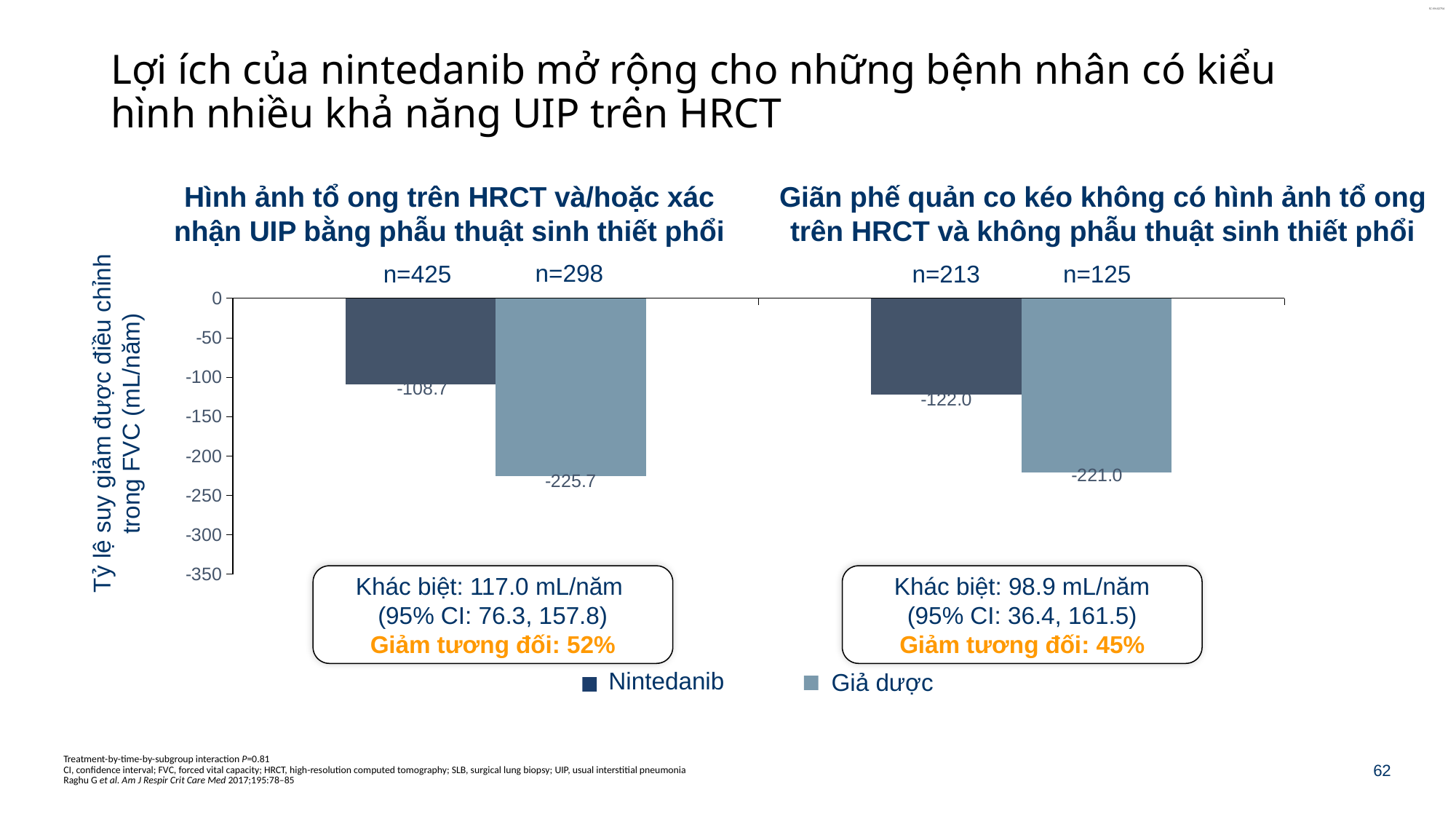
What is the adjusted annual rate of FVC decline for Nintedanib in the group 'Hình ảnh tổ ong trên HRCT và/hoặc xác nhận UIP bằng phẫu thuật sinh thiết phổi'? -108.7 What is the adjusted annual rate of FVC decline for Giả dược in the group 'Giãn phế quản co kéo không có hình ảnh tổ ong trên HRCT và không phẫu thuật sinh thiết phổi'? -221.0 Which bar shows the largest decline in FVC (the most negative value) on the chart? Giả dược in the 'Hình ảnh tổ ong trên HRCT và/hoặc xác nhận UIP bằng phẫu thuật sinh thiết phổi' group (-225.7) What is the adjusted annual rate of FVC decline for Giả dược in the group 'Hình ảnh tổ ong trên HRCT và/hoặc xác nhận UIP bằng phẫu thuật sinh thiết phổi'? -225.7 Which bar shows the smallest decline in FVC (the least negative value) on the chart? Nintedanib in the 'Hình ảnh tổ ong trên HRCT và/hoặc xác nhận UIP bằng phẫu thuật sinh thiết phổi' group (-108.7) Is the Nintedanib value in the 'Giãn phế quản co kéo không có hình ảnh tổ ong trên HRCT và không phẫu thuật sinh thiết phổi' group greater or less than -100? less What is the difference between the Nintedanib and Giả dược values in the 'Giãn phế quản co kéo không có hình ảnh tổ ong trên HRCT và không phẫu thuật sinh thiết phổi' group? 99.0 mL/năm What is the relative reduction shown for the 'Giãn phế quản co kéo không có hình ảnh tổ ong trên HRCT và không phẫu thuật sinh thiết phổi' group? 45% What kind of chart is shown on the slide? Bar chart How many series does the legend list? 2 What is the difference between the Nintedanib and Giả dược values in the 'Hình ảnh tổ ong trên HRCT và/hoặc xác nhận UIP bằng phẫu thuật sinh thiết phổi' group? 117.0 mL/năm What is the adjusted annual rate of FVC decline for Nintedanib in the group 'Giãn phế quản co kéo không có hình ảnh tổ ong trên HRCT và không phẫu thuật sinh thiết phổi'? -122.0